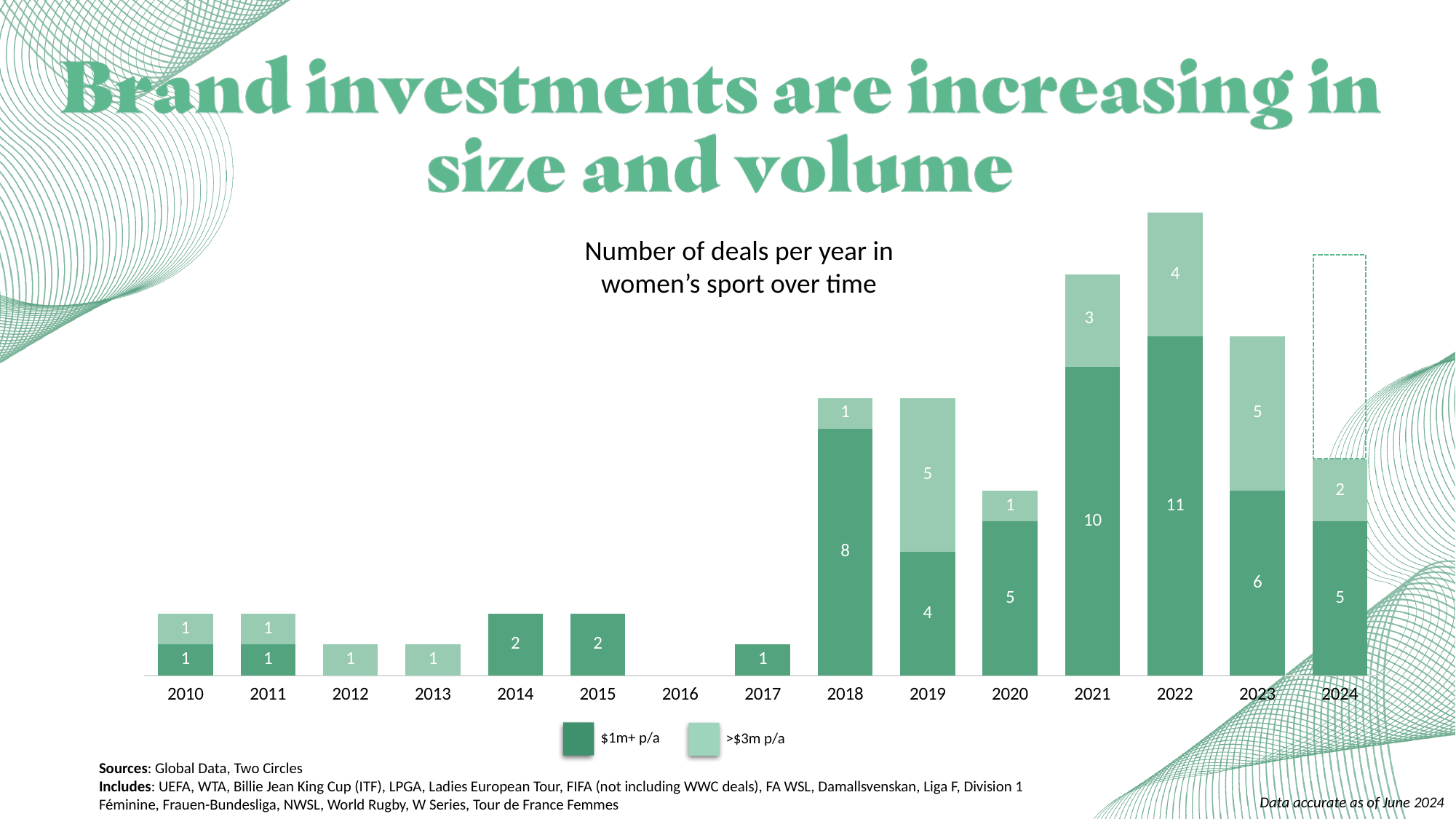
What are the two series named in the legend? $1m+ p/a and >$3m p/a What kind of chart is shown on the slide? Stacked bar chart How many deals of >$3m p/a were there in 2024? 2 Which year has the highest number of $1m+ p/a deals? 2022 How many series does the legend list? 2 Which year had more >$3m p/a deals, 2018 or 2019? 2019 What is the total number of deals in 2022 (both series combined)? 15 What is the difference between the $1m+ p/a deals in 2022 and in 2021? 1 How many deals of $1m+ p/a were there in 2022? 11 How many deals of >$3m p/a were there in 2019? 5 How many years are shown on the x axis? 15 What is the total number of deals in 2021 (both series combined)? 13